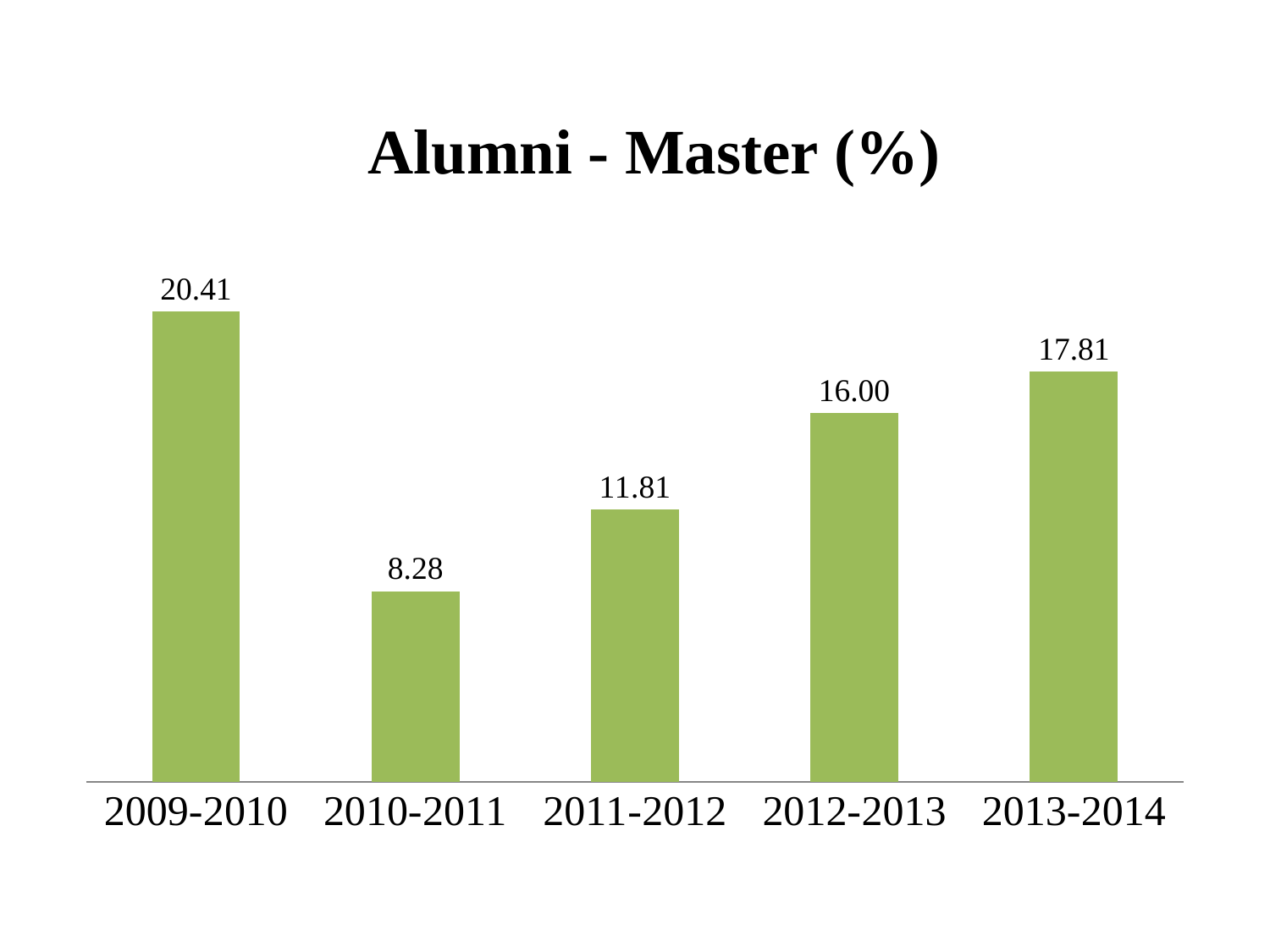
What kind of chart is this? Bar chart How many years are shown on the chart? 5 What is the title of the chart? Alumni - Master (%) Which is larger, the value for 2012-2013 or the value for 2013-2014? 2013-2014 What is the value for 2010-2011? 8.28 What is the value for 2011-2012? 11.81 What is the value for 2009-2010? 20.41 What is the value for 2012-2013? 16.00 Which year has the highest value? 2009-2010 What is the difference between the values for 2009-2010 and 2010-2011? 12.13 What is the value for 2013-2014? 17.81 Which year has the lowest value? 2010-2011